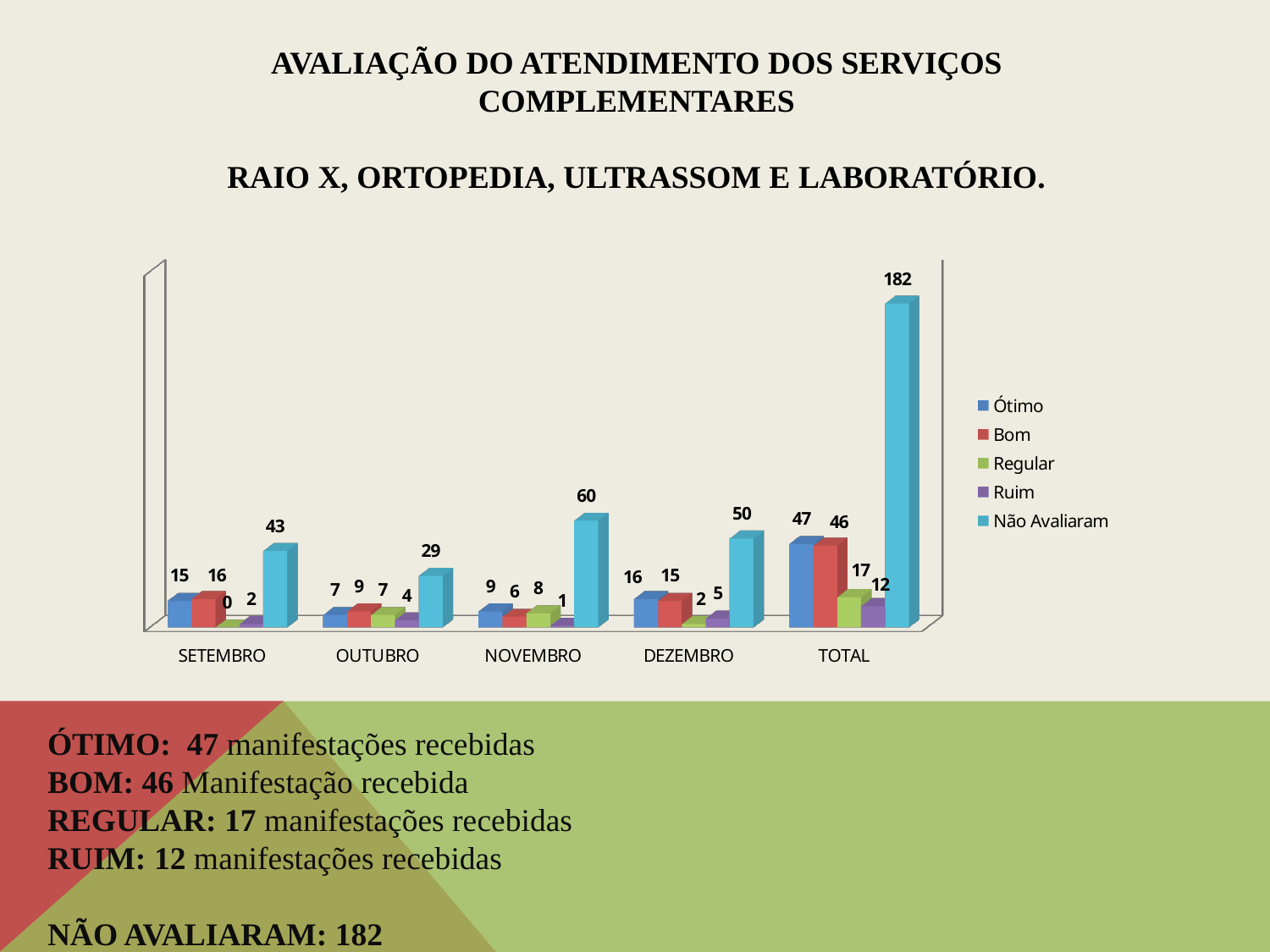
What kind of chart is shown on the slide? Bar chart How many categories are shown on the x axis? 5 What is the value for Ruim in DEZEMBRO? 5 What is the value for Ótimo in SETEMBRO? 15 Which category has the highest value for Não Avaliaram? TOTAL What is the value for Regular in OUTUBRO? 7 Which category has the lowest value for Ruim? NOVEMBRO What is the value for Não Avaliaram in NOVEMBRO? 60 What is the difference between Não Avaliaram in NOVEMBRO and in DEZEMBRO? 10 Which is larger, Ótimo in DEZEMBRO or Bom in DEZEMBRO? Ótimo in DEZEMBRO How many series does the legend list? 5 Which legend entry is shown in light blue? Não Avaliaram